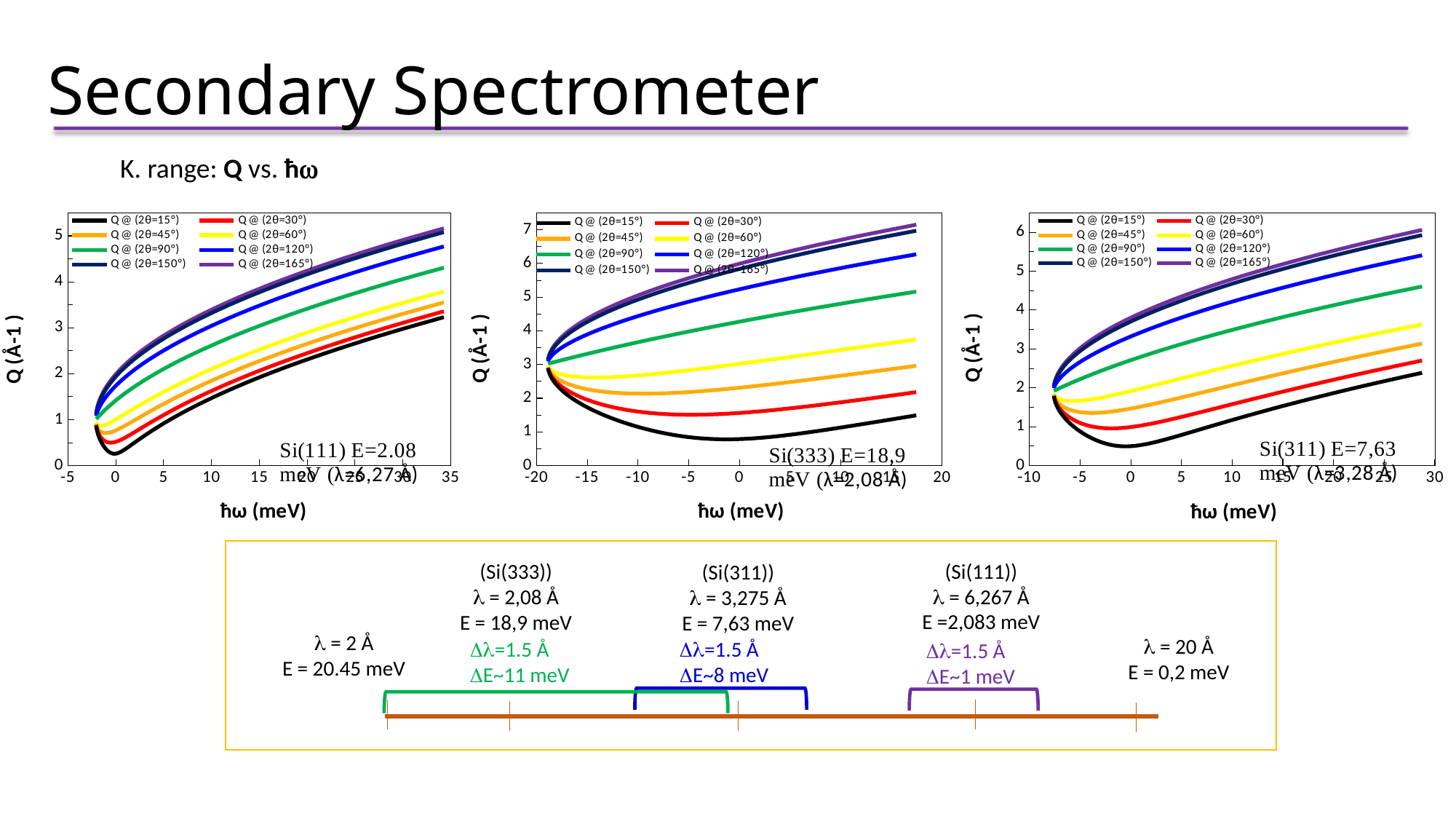
In the middle chart (Si(333) E=18,9 meV), at ħω=10, which is larger: the Q @ (2θ=90°) series or the Q @ (2θ=30°) series? Q @ (2θ=90°) In the right chart (Si(311) E=7,63 meV), is the value of the Q @ (2θ=15°) series at ħω=0 greater or less than 1? less In the middle chart (Si(333) E=18,9 meV), is the value of the Q @ (2θ=15°) series at ħω=0 greater or less than 1? less In the left chart (Si(111) E=2.08 meV), is the value of the Q @ (2θ=165°) series at ħω=20 greater or less than 4? greater What is the x-axis label of the right chart (Si(311) E=7,63 meV)? ħω (meV) What kind of chart is the left chart (Si(111) E=2.08 meV)? line chart In the right chart (Si(311) E=7,63 meV), does the Q @ (2θ=165°) series rise or fall as ħω increases from 0 to 25? rise How many charts are shown on the slide? 3 In the middle chart (Si(333) E=18,9 meV), which series is lowest at the right end of the x axis? Q @ (2θ=15°) How many series does the legend of the middle chart (Si(333) E=18,9 meV) list? 8 In the left chart (Si(111) E=2.08 meV), what colour is the Q @ (2θ=90°) series? green